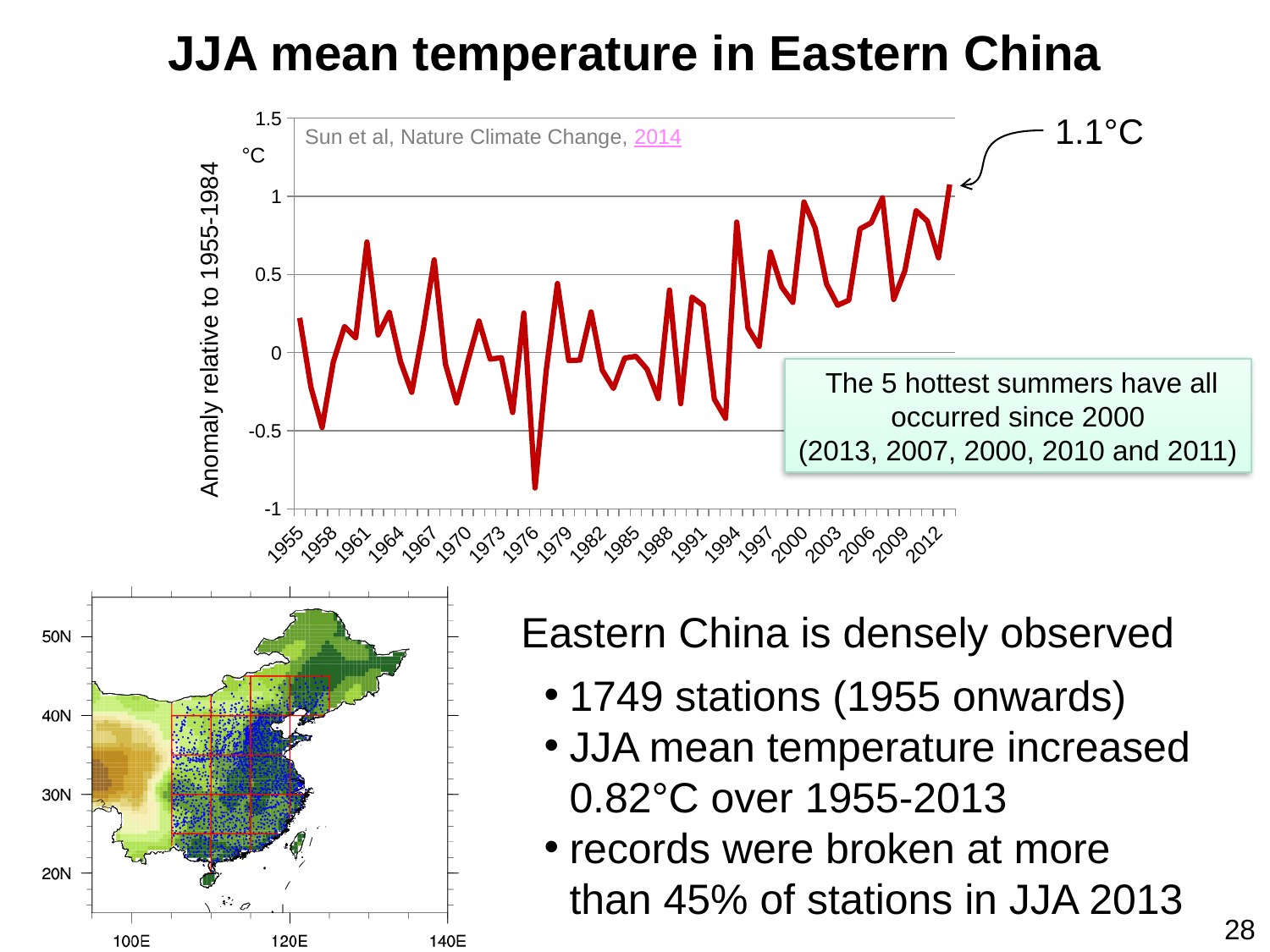
What is the label on the y-axis of the chart? Anomaly relative to 1955-1984 How many data series are plotted on the chart? 1 Is the value for 2013 greater or less than 1? greater Which is larger, the anomaly for 1955 or the anomaly for 2013? 2013 According to the text box on the chart, which five years were the hottest summers? 2013, 2007, 2000, 2010 and 2011 What is the JJA mean temperature anomaly value annotated for 2013 on the chart? 1.1°C Is the value for 1955 greater or less than 0.5? less Which year has the highest JJA mean temperature anomaly on the chart? 2013 Is the lowest value on the chart greater or less than -0.5? less Do the JJA mean temperature anomalies generally rise or fall from 1955 to 2013? rise What kind of chart is used to show the JJA mean temperature anomaly in Eastern China? line chart